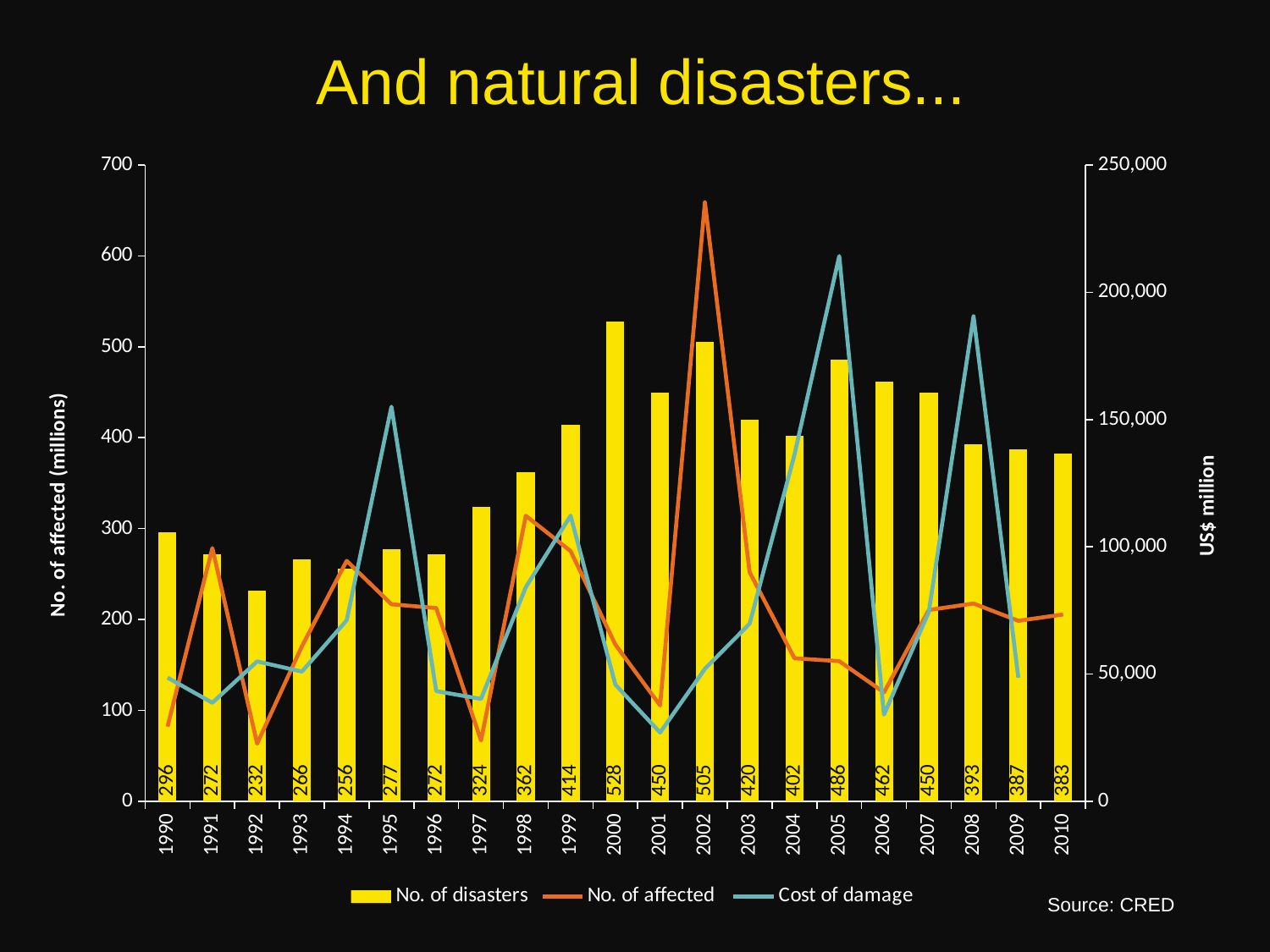
What is the number of disasters in 1992? 232 How many years are shown on the x axis? 21 Is the Cost of damage value for 2005 greater or less than 200,000? greater What is the difference between the number of disasters in 2000 and in 1990? 232 Which year has the highest number of disasters? 2000 What is the number of disasters in 2000? 528 What is the source cited for the chart? CRED Which year has more disasters, 2002 or 2003? 2002 Which year has the lowest number of disasters? 1992 How many series does the legend list? 3 Is the No. of affected value for 2002 greater or less than 600 on the left axis? greater What is the number of disasters in 2005? 486